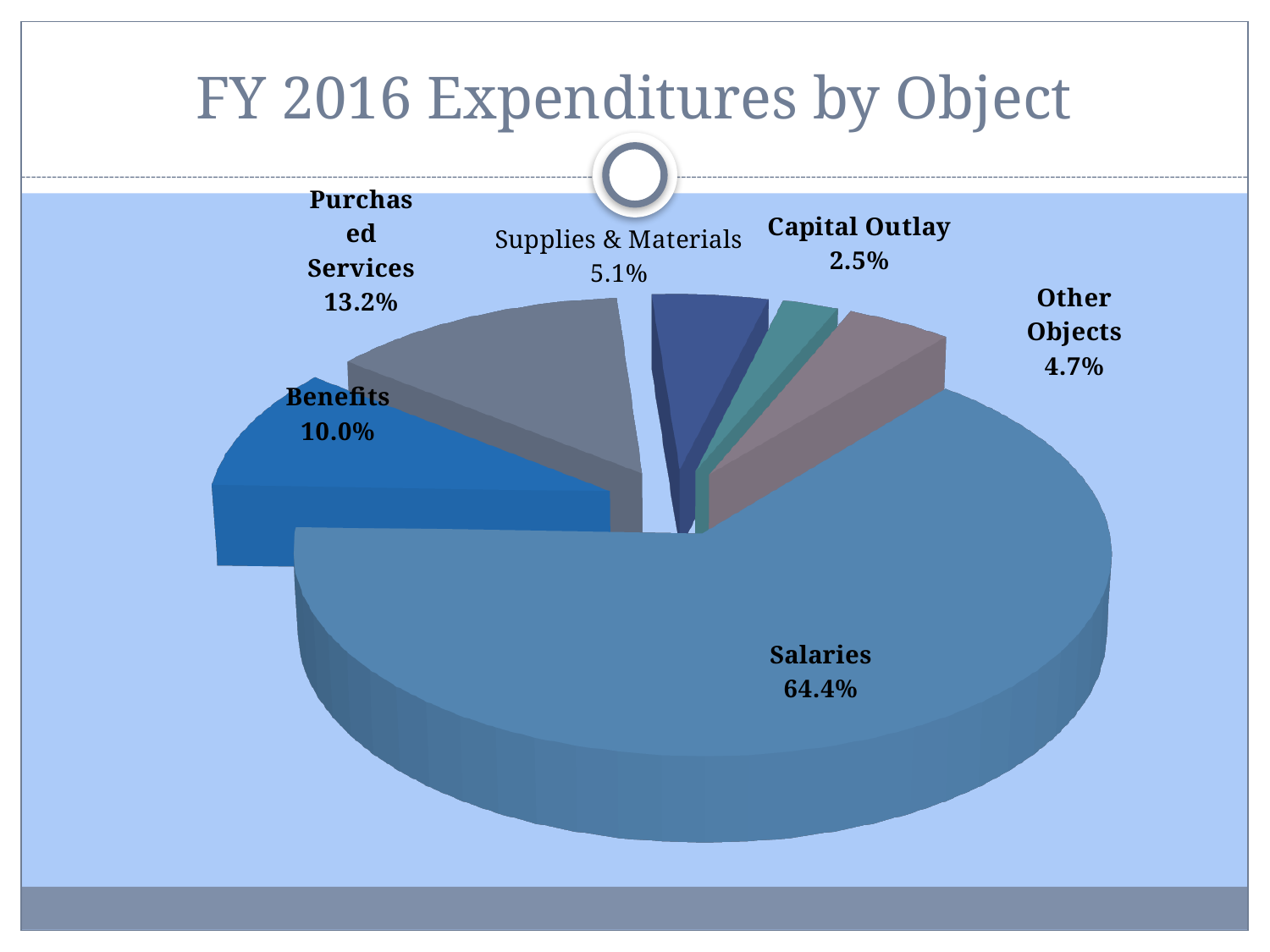
What percentage is shown for Supplies & Materials? 5.1% Which expenditure category has the largest share? Salaries How many expenditure categories are shown in the pie chart? 6 What percentage is shown for Other Objects? 4.7% Which is larger, Supplies & Materials or Other Objects? Supplies & Materials What is the difference in percentage points between Purchased Services and Benefits? 3.2 What percentage of expenditures is Purchased Services? 13.2% Which expenditure category has the smallest share? Capital Outlay What type of chart is shown on the slide? Pie chart What share of expenditures is Capital Outlay? 2.5% What share of expenditures is Benefits? 10.0% What share of FY 2016 expenditures is Salaries? 64.4%